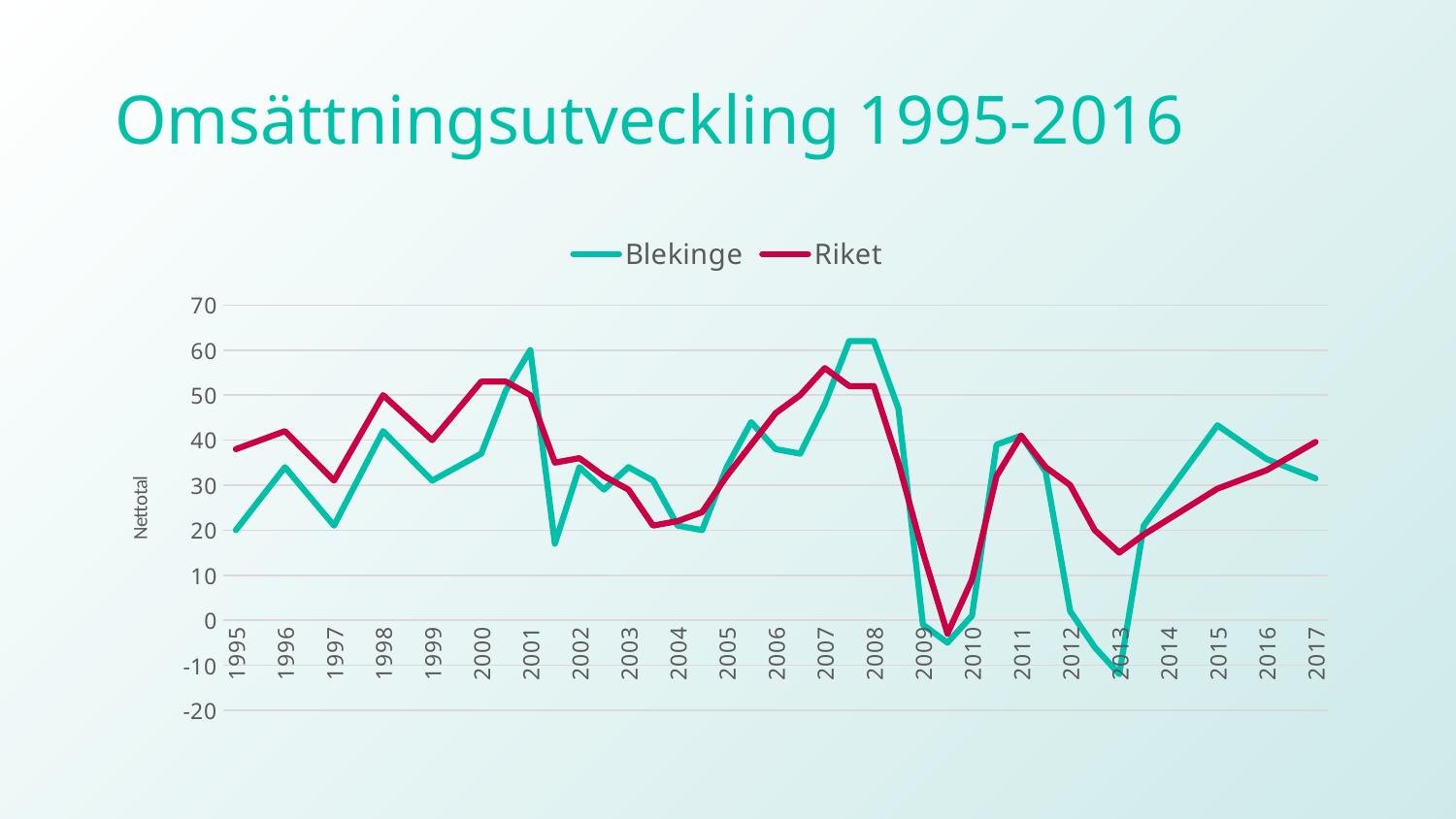
What kind of chart is shown on the slide? line chart How many year labels are shown on the x axis? 23 Is the value for Riket in 2017 greater or less than 30? greater In 2013, which series has the higher value, Blekinge or Riket? Riket Is the value for Riket in 1995 greater or less than 30? greater How many series does the legend list? 2 In 2008, which series has the higher value, Blekinge or Riket? Blekinge In which year does the Blekinge line reach its lowest value? 2013 Is the value for Blekinge in 2013 greater or less than 0? less In which year does the Blekinge line reach its highest value? 2008 What is the label on the y axis? Nettotal